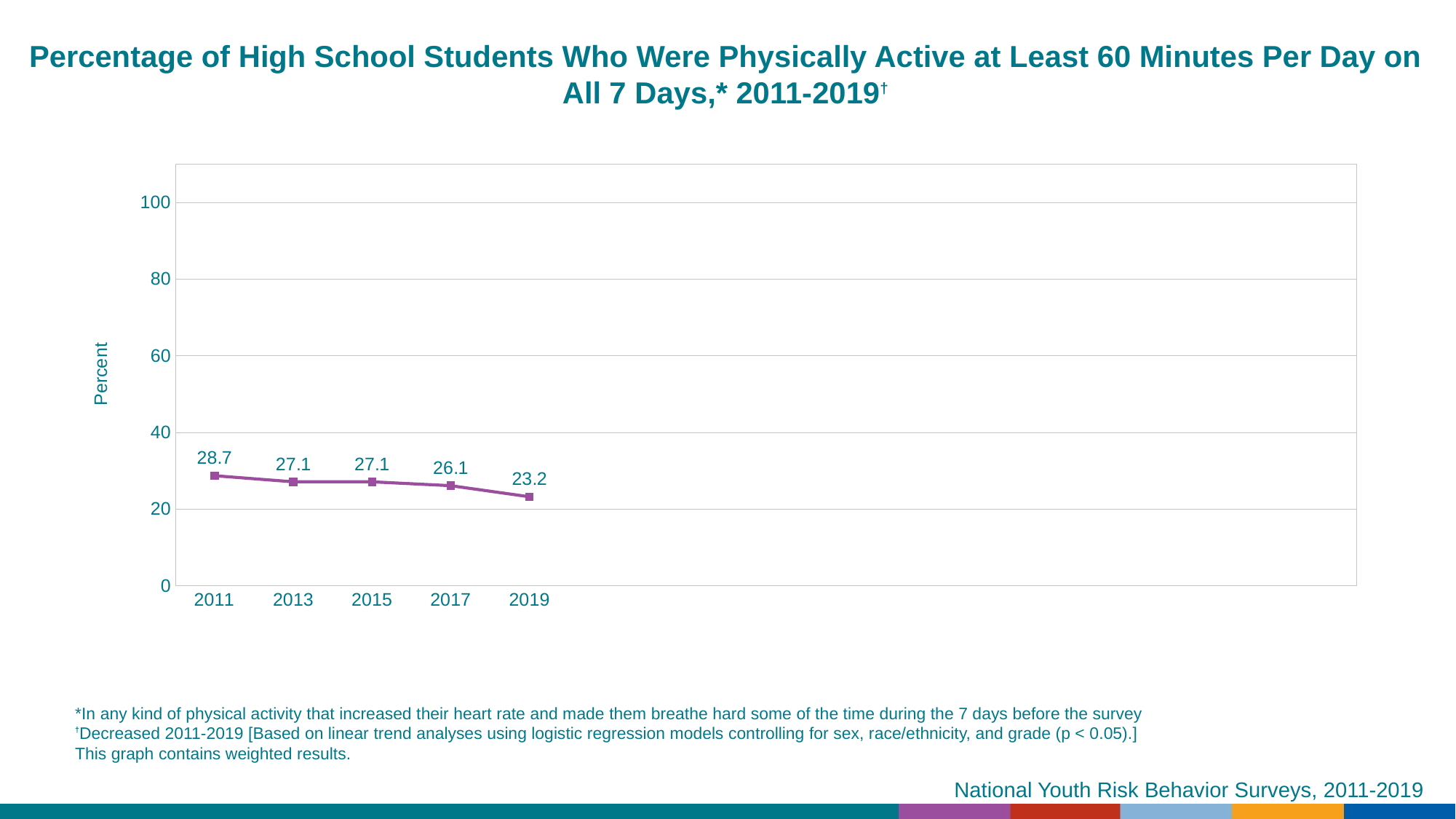
What value is shown for 2019? 23.2 What is the difference between the 2017 value and the 2019 value? 2.9 Which year has the lowest value on the chart? 2019 How many years are plotted on the chart? 5 What was the percentage of high school students physically active at least 60 minutes per day on all 7 days in 2011? 28.7 Do the values rise or fall from 2011 to 2019? fall What value is shown for 2017? 26.1 Which is larger, the value for 2011 or the value for 2017? 2011 Which year has the highest value on the chart? 2011 Is the value for 2019 greater or less than 40? less What kind of chart is shown on the slide? line chart What is the difference between the 2011 value and the 2019 value? 5.5